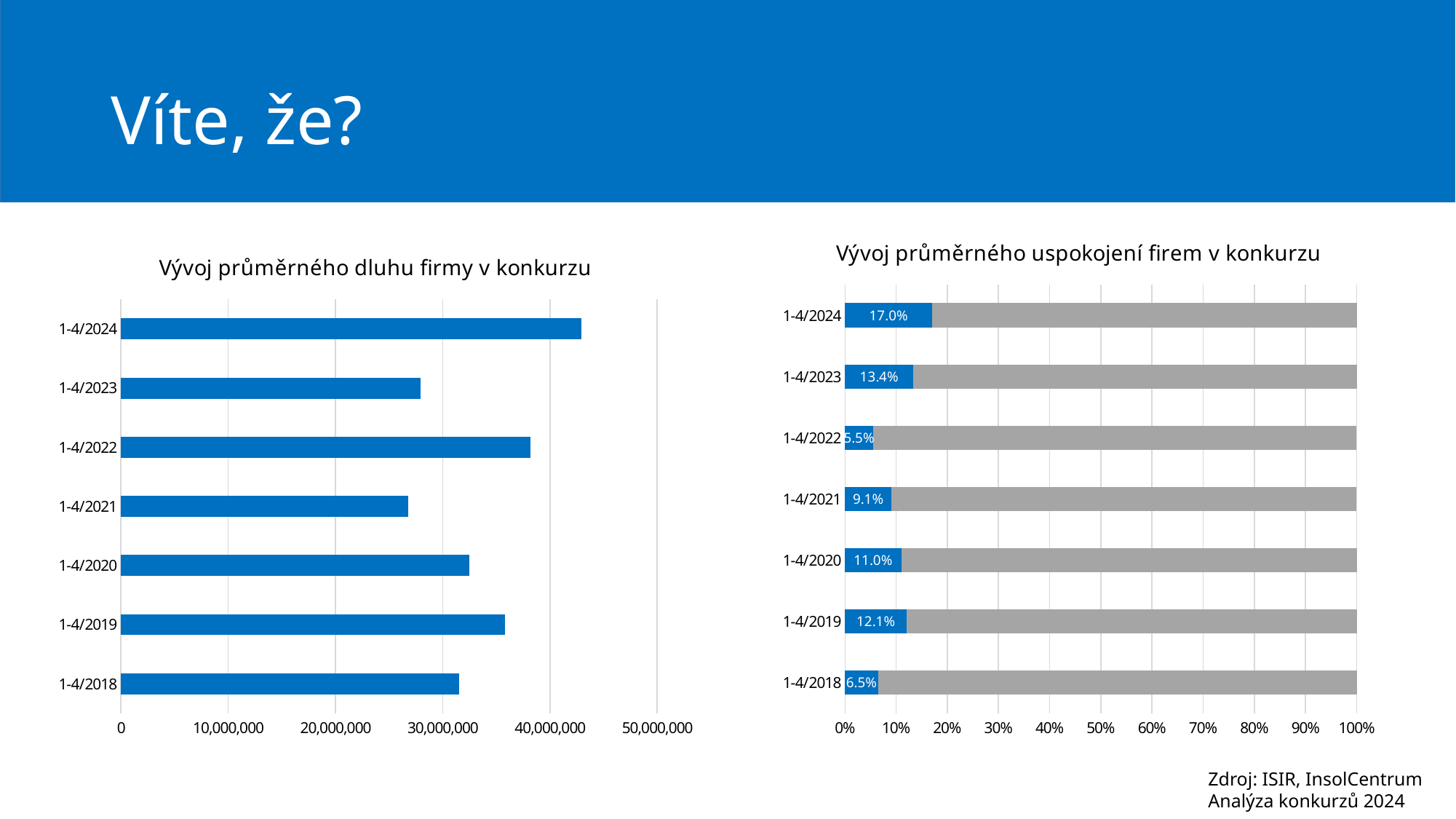
In the chart 'Vývoj průměrného uspokojení firem v konkurzu', what is the value for 1-4/2019? 12.1% How many periods are shown in the chart 'Vývoj průměrného dluhu firmy v konkurzu'? 7 What type of chart is 'Vývoj průměrného dluhu firmy v konkurzu'? Bar chart In the chart 'Vývoj průměrného uspokojení firem v konkurzu', which is larger, the value for 1-4/2020 or 1-4/2021? 1-4/2020 In the chart 'Vývoj průměrného uspokojení firem v konkurzu', which period has the lowest value? 1-4/2022 In the chart 'Vývoj průměrného uspokojení firem v konkurzu', what is the value for 1-4/2022? 5.5% In the chart 'Vývoj průměrného uspokojení firem v konkurzu', which period has the highest value? 1-4/2024 In the chart 'Vývoj průměrného dluhu firmy v konkurzu', is the value for 1-4/2024 greater or less than 40,000,000? greater In the chart 'Vývoj průměrného uspokojení firem v konkurzu', what is the value for 1-4/2024? 17.0% In the chart 'Vývoj průměrného uspokojení firem v konkurzu', what is the difference between the values for 1-4/2024 and 1-4/2023? 3.6 percentage points In the chart 'Vývoj průměrného dluhu firmy v konkurzu', which period has the highest value? 1-4/2024 In the chart 'Vývoj průměrného dluhu firmy v konkurzu', is the value for 1-4/2023 greater or less than 30,000,000? less